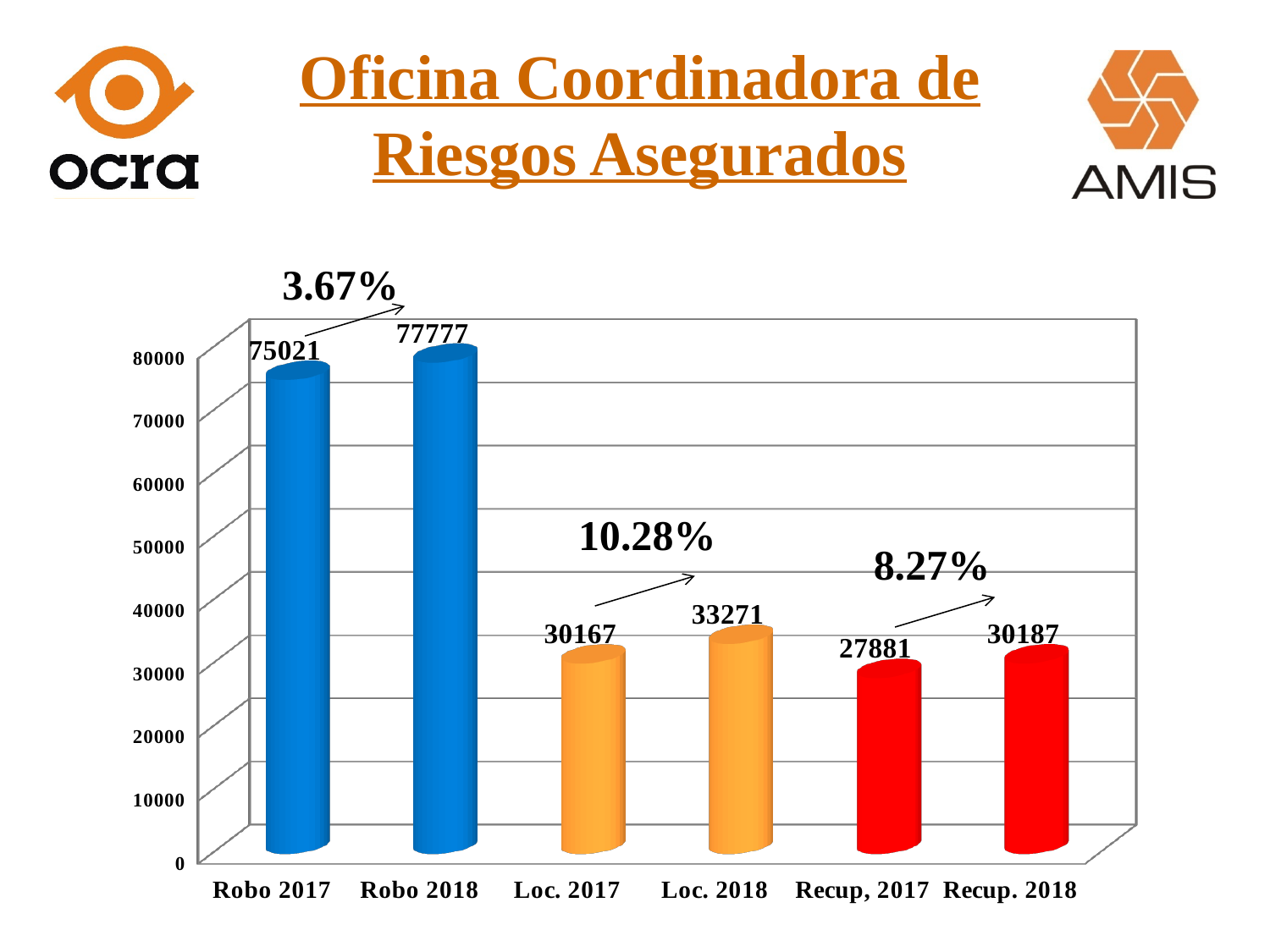
Is the value for Recup, 2017 greater or less than 30000? less Which category has the highest value? Robo 2018 What is the value for Loc. 2018? 33271 Which is larger, Loc. 2017 or Recup. 2018? Recup. 2018 What is the value for Robo 2017? 75021 What is the value for Recup. 2018? 30187 Which category has the lowest value? Recup, 2017 What is the difference between Robo 2018 and Robo 2017? 2756 What is the difference between Loc. 2018 and Loc. 2017? 3104 How many bars are shown in the chart? 6 What kind of chart is shown on the slide? bar chart What percentage change is annotated between Loc. 2017 and Loc. 2018? 10.28%